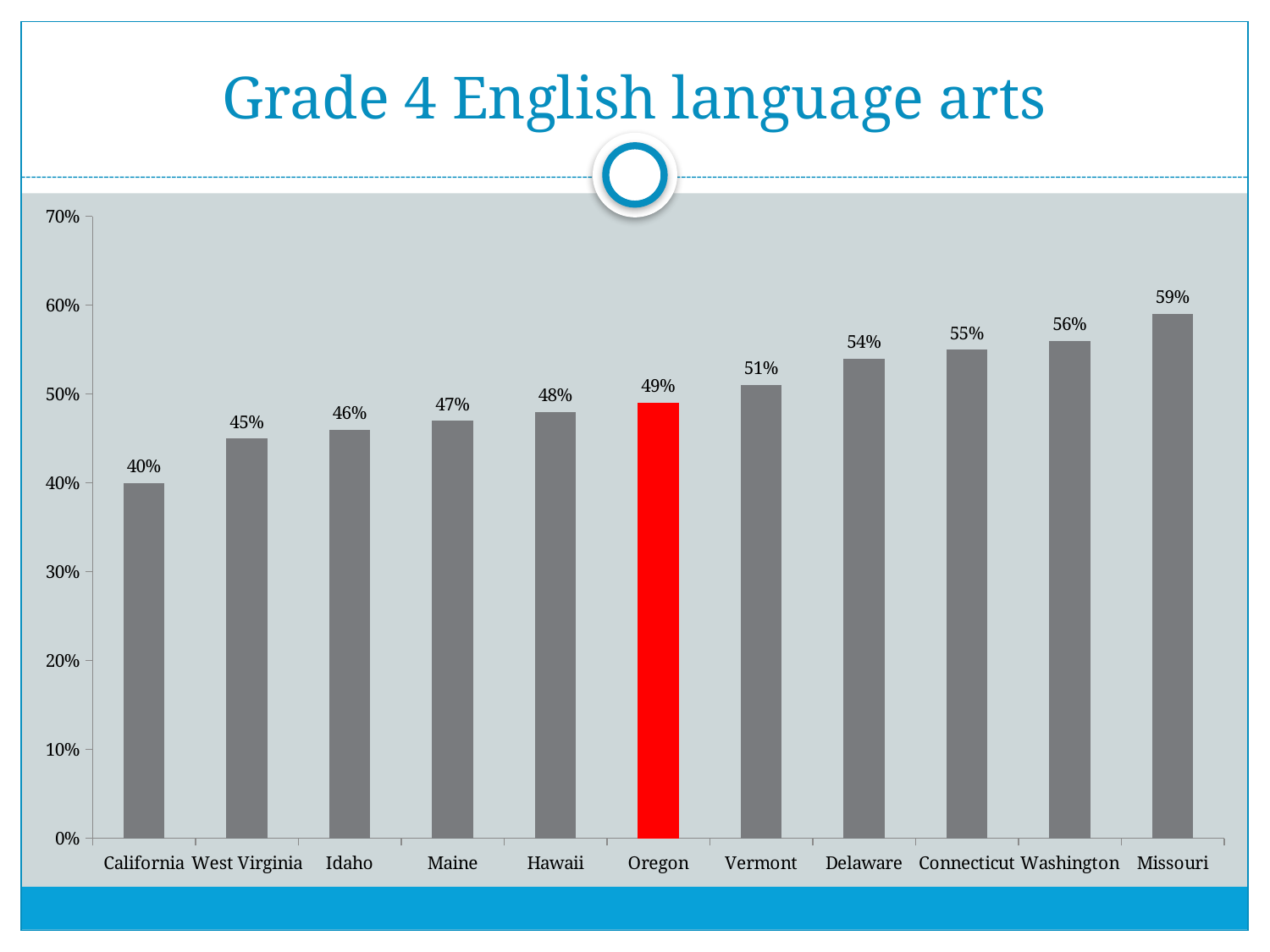
Which bar is highlighted in red? Oregon What is the difference between the values for Missouri and California? 19% Which state has the highest value? Missouri Which is larger, the value for Delaware or the value for Maine? Delaware How many states are shown on the chart? 11 Is the value for Washington greater or less than 50%? greater Which state has the lowest value? California What is the value for California? 40% What is the difference between the values for Oregon and Vermont? 2% What kind of chart is shown on the slide? bar chart What is the value for Connecticut? 55% What is the value for Oregon? 49%